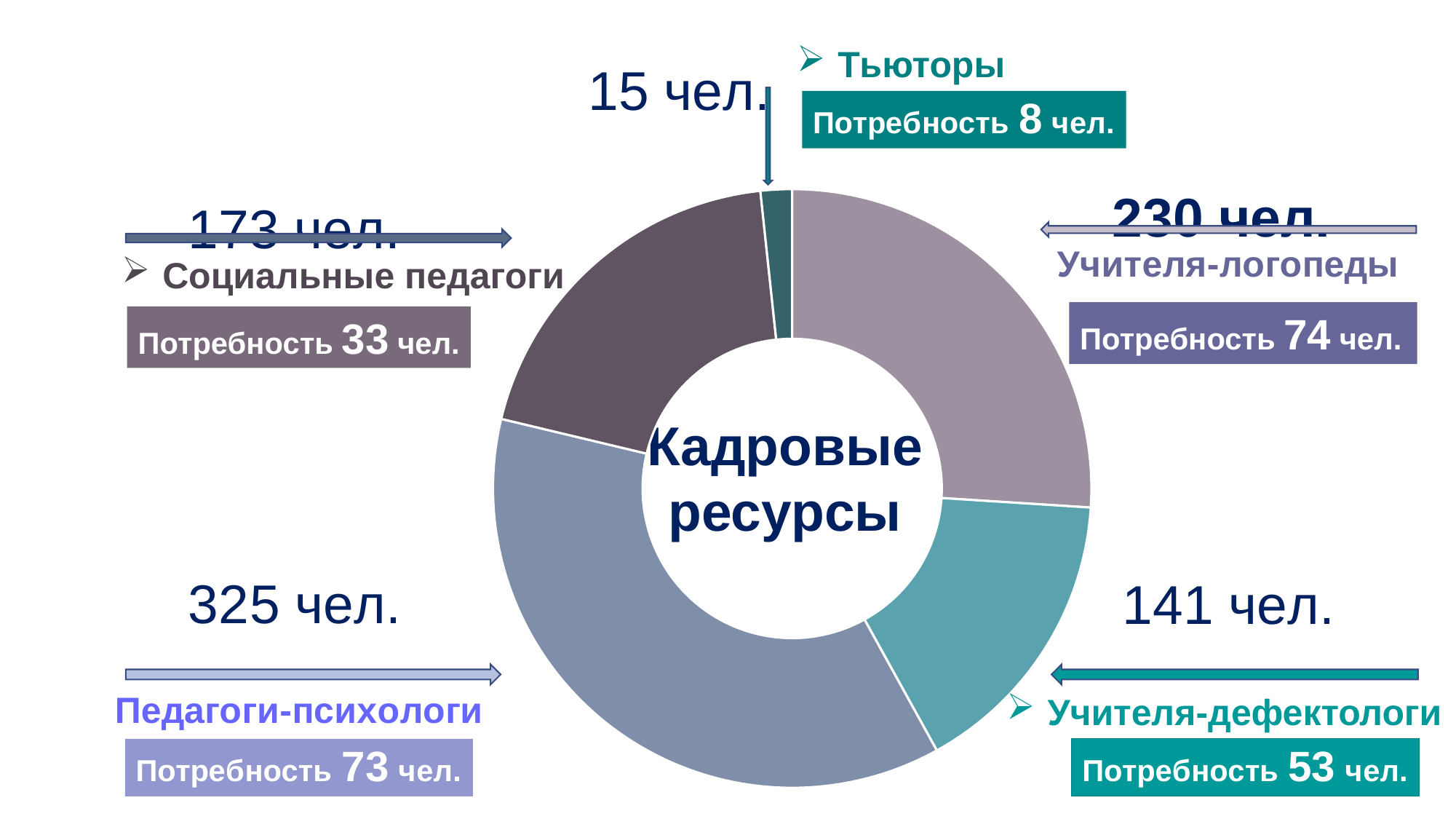
Which is larger, the value for Социальные педагоги or the value for Учителя-дефектологи? Социальные педагоги What is the value shown for Тьюторы? 15 чел. How many categories does the donut chart have? 5 What is the total of all five values in the donut chart? 884 чел. What is the value shown for Учителя-логопеды? 230 чел. What kind of chart is shown on the slide? Donut (pie) chart What title is shown in the centre of the donut chart? Кадровые ресурсы Which category has the smallest slice of the donut chart? Тьюторы What is the value shown for Учителя-дефектологи? 141 чел. Which category has the largest slice of the donut chart? Педагоги-психологи What is the difference between the values for Педагоги-психологи and Учителя-логопеды? 95 чел. What is the value shown for Педагоги-психологи? 325 чел.